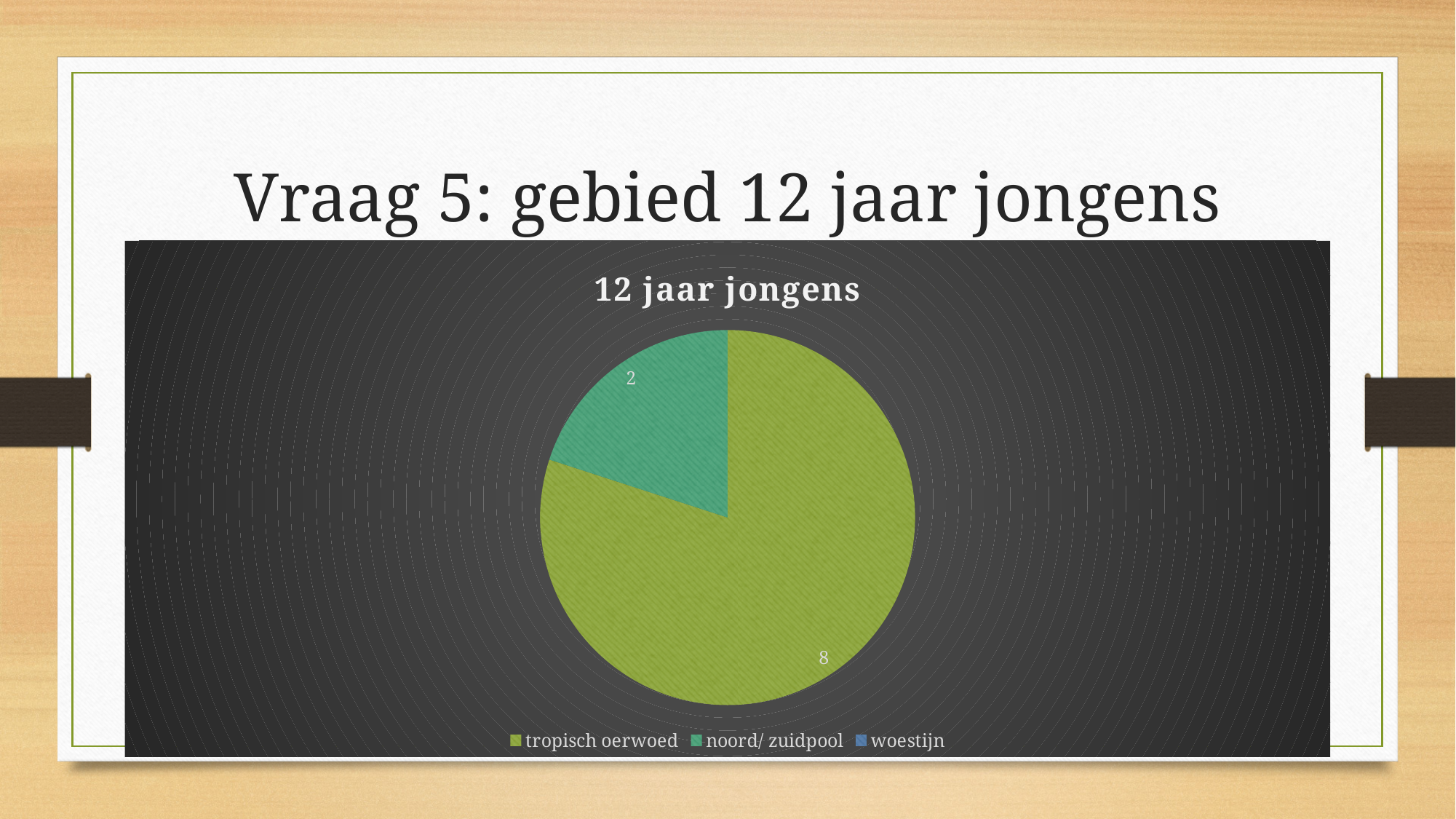
Which is larger, the value for tropisch oerwoed or the value for noord/ zuidpool? tropisch oerwoed Which category has the largest slice of the pie? tropisch oerwoed What colour is the slice for noord/ zuidpool? teal How many slices are visible in the pie? 2 What is the value for tropisch oerwoed? 8 What is the difference between the value for tropisch oerwoed and the value for noord/ zuidpool? 6 What share of the pie does tropisch oerwoed represent? 80% What is the title of the chart? 12 jaar jongens What type of chart is shown on the slide? pie chart What is the value for noord/ zuidpool? 2 How many entries does the legend list? 3 What share of the pie does noord/ zuidpool represent? 20%